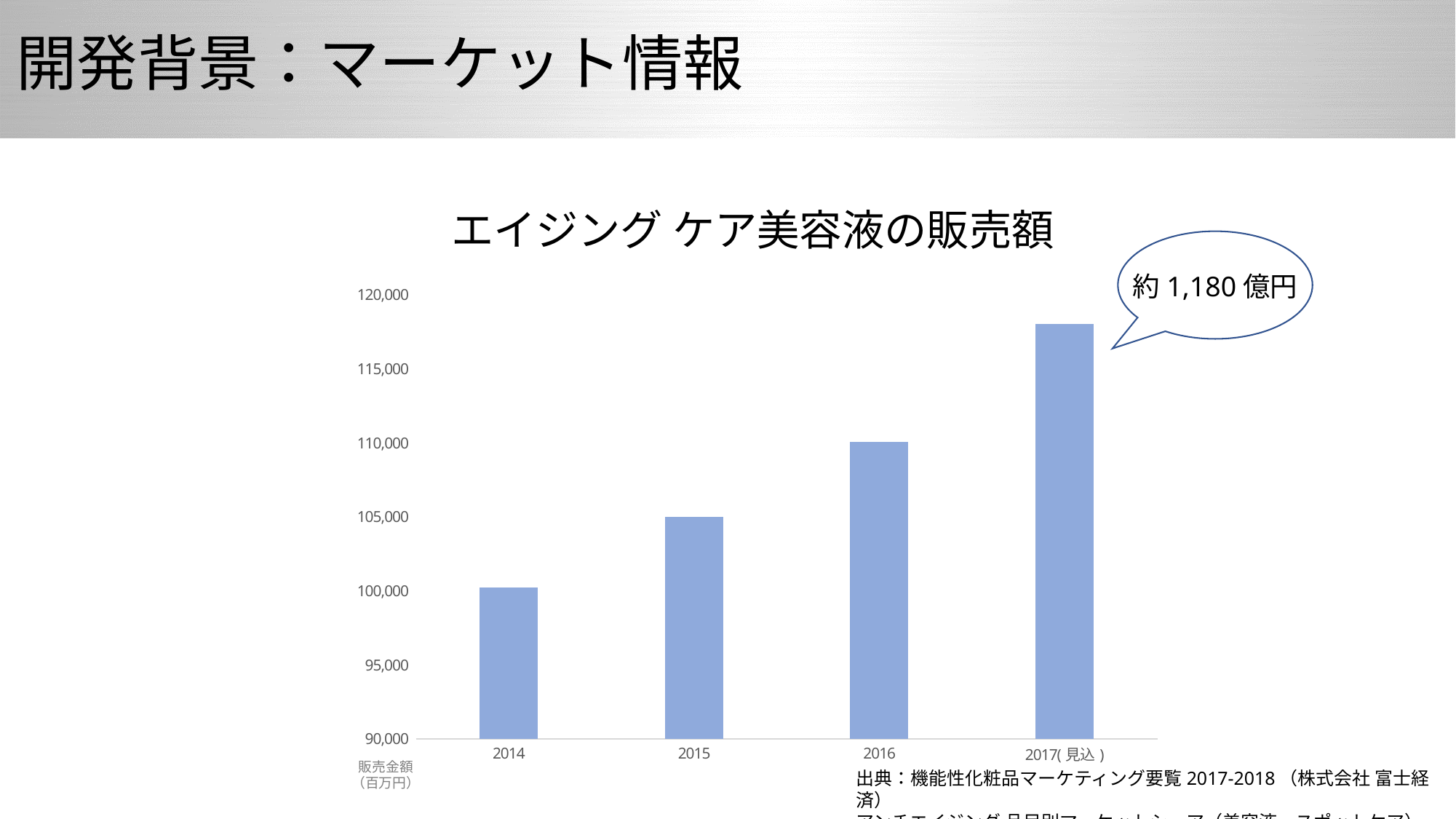
Which year has the lowest sales value in the chart? 2014 Which year has the highest sales value in the chart? 2017(見込) How many categories (years) are shown on the x axis of the chart? 4 What is the title of the chart? エイジング ケア美容液の販売額 Is the value for 2016 greater or less than 115,000? less Is the value for 2015 greater or less than 100,000? greater Which is larger, the value for 2015 or the value for 2016? 2016 What does the callout next to the 2017(見込) bar say? 約 1,180 億円 Is the value for 2017(見込) greater or less than 115,000? greater What kind of chart is shown on the slide? bar chart Do the sales values rise or fall from 2014 to 2017(見込)? rise